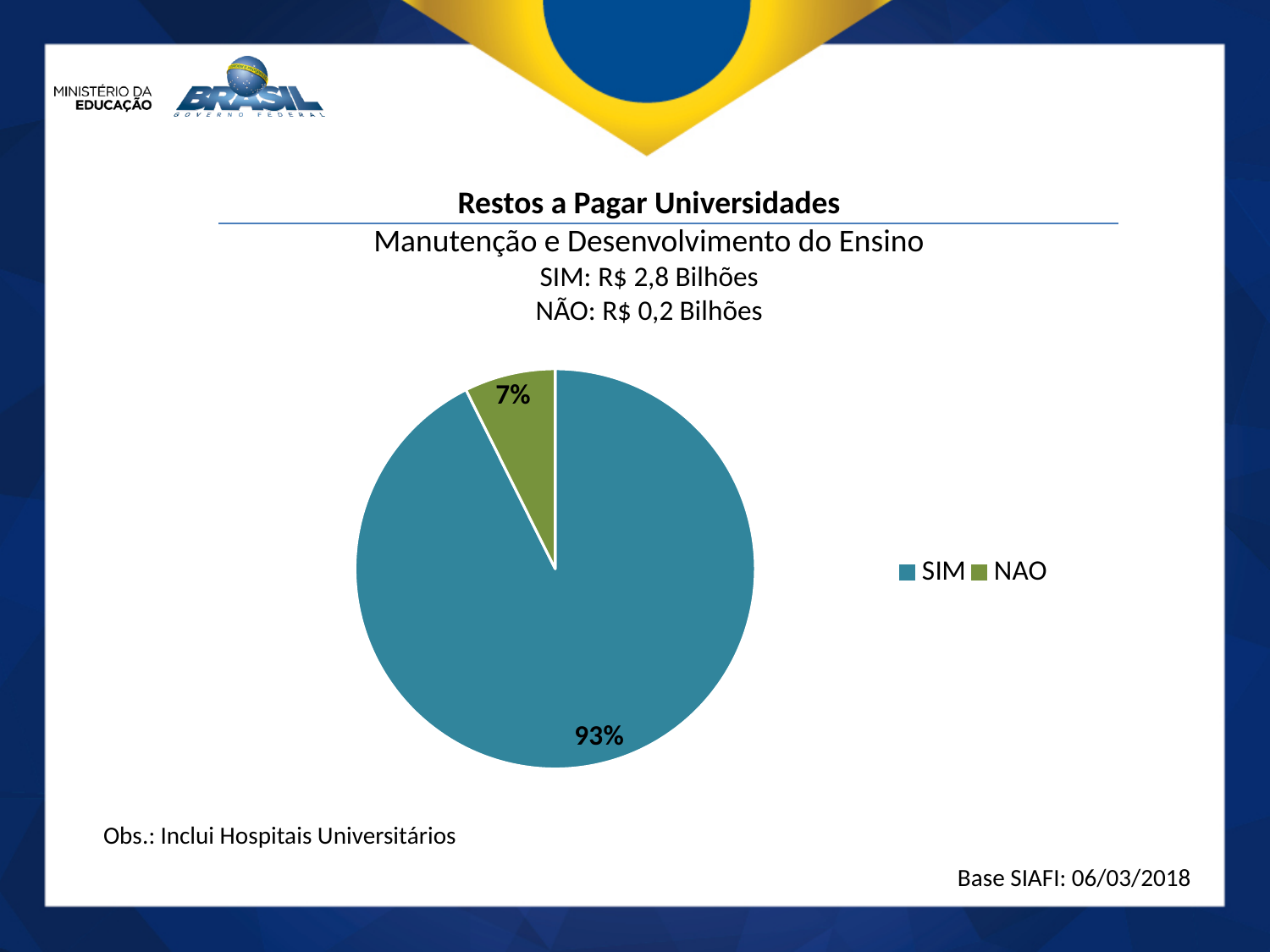
What share of the pie does the SIM slice represent? 93% Which slice of the pie is the largest? SIM What is the title of the chart? Restos a Pagar Universidades What share of the pie does the NAO slice represent? 7% What is the difference in percentage points between the SIM and NAO slices? 86 percentage points Which is larger, the SIM slice or the NAO slice? SIM Which slice of the pie is the smallest? NAO What kind of chart is shown on the slide? pie chart What colour is the SIM slice in the pie chart? blue How many slices does the pie chart have? 2 According to the text above the chart, what is the value for SIM? R$ 2,8 Bilhões How many entries does the legend list? 2